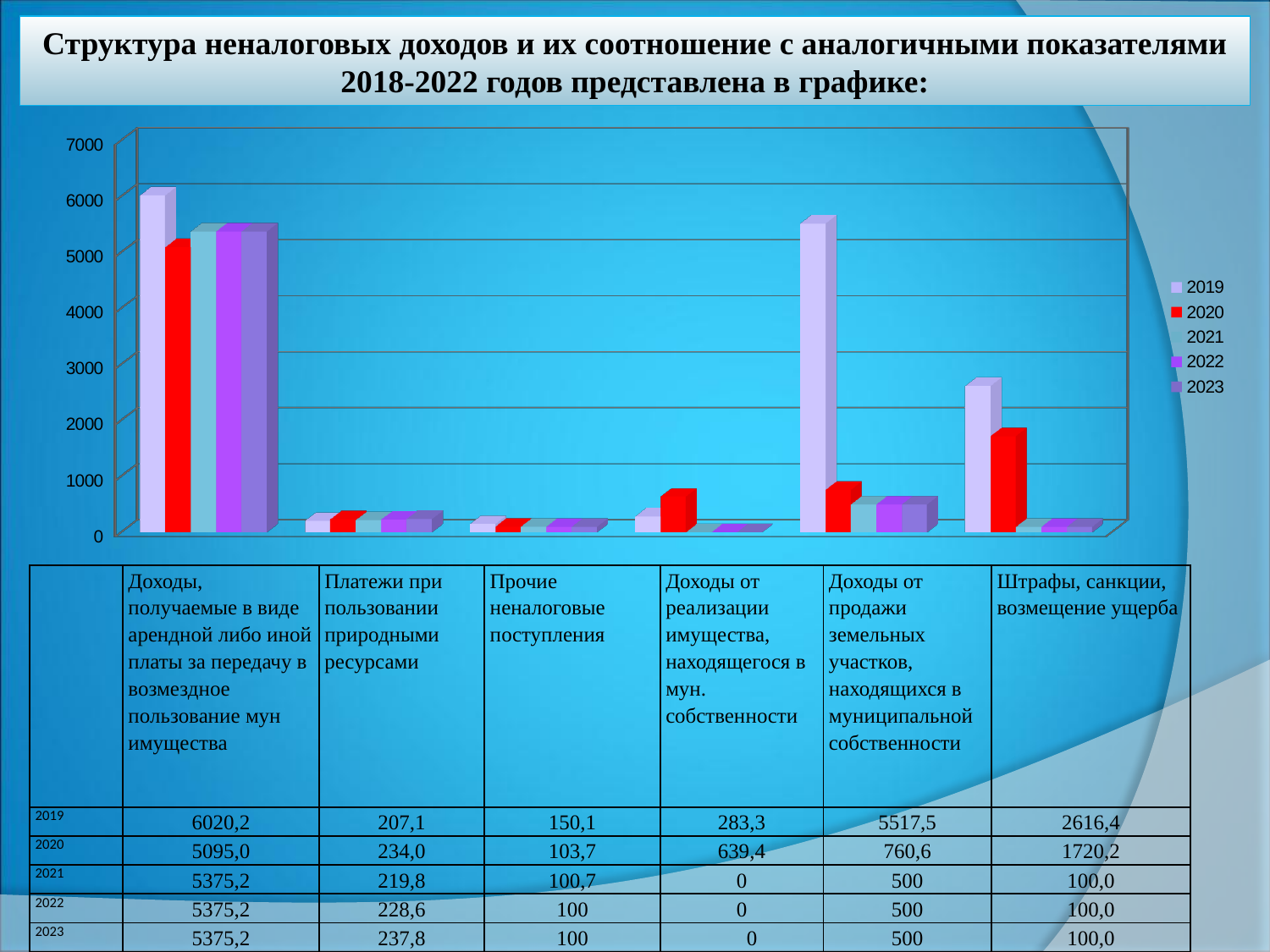
Which year has the lowest value in the category 'Доходы от реализации имущества, находящегося в мун. собственности' among years with a non-zero value? 2019 How many series does the legend list? 5 Is the 2019 value for 'Доходы от продажи земельных участков, находящихся в муниципальной собственности' greater or less than 5000? greater What is the value for 2023 in the category 'Платежи при пользовании природными ресурсами'? 237,8 Which year has the highest value in the category 'Доходы, получаемые в виде арендной либо иной платы за передачу в возмездное пользование мун имущества'? 2019 Which is larger: the 2020 value for 'Доходы от реализации имущества, находящегося в мун. собственности' or the 2020 value for 'Доходы от продажи земельных участков, находящихся в муниципальной собственности'? Доходы от продажи земельных участков, находящихся в муниципальной собственности How many categories are plotted along the x axis? 6 What is the difference between the 2019 and 2020 values in the category 'Штрафы, санкции, возмещение ущерба'? 896,2 What is the value for 2020 in the category 'Штрафы, санкции, возмещение ущерба'? 1720,2 What is the value for 2019 in the category 'Доходы от продажи земельных участков, находящихся в муниципальной собственности'? 5517,5 What kind of chart is shown on the slide? bar chart Which colour represents the 2020 series in the legend? red